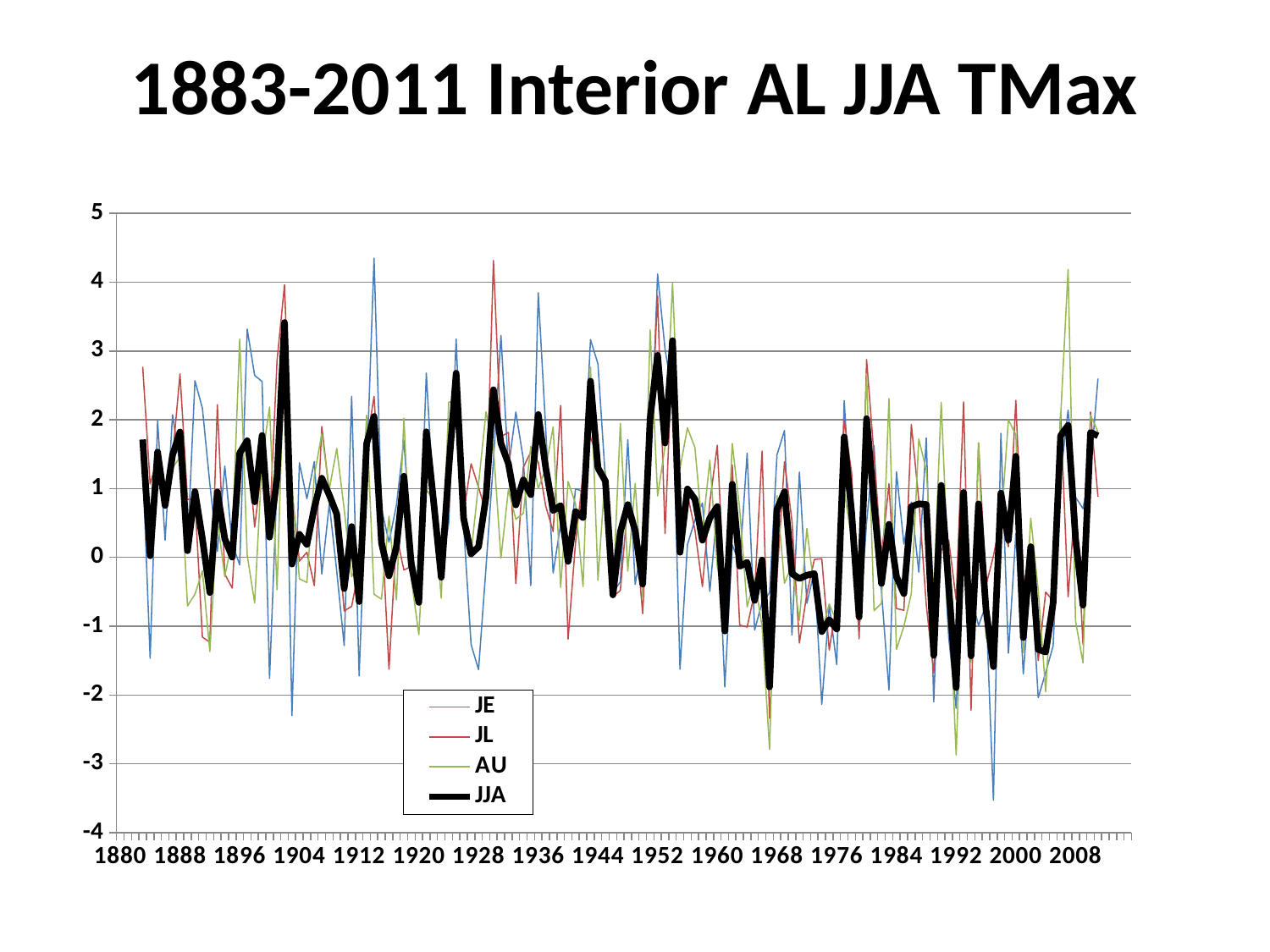
Is the lowest value reached by the AU series greater or less than -2? less Is the last plotted value of the JJA series (at the right end of the chart) greater or less than 1? greater What kind of chart is shown on the slide? line chart Is the lowest value reached by the JE series greater or less than -3? less Which series is drawn with the thick black line? JJA How many series does the legend list? 4 What is the title of the chart? 1883-2011 Interior AL JJA TMax